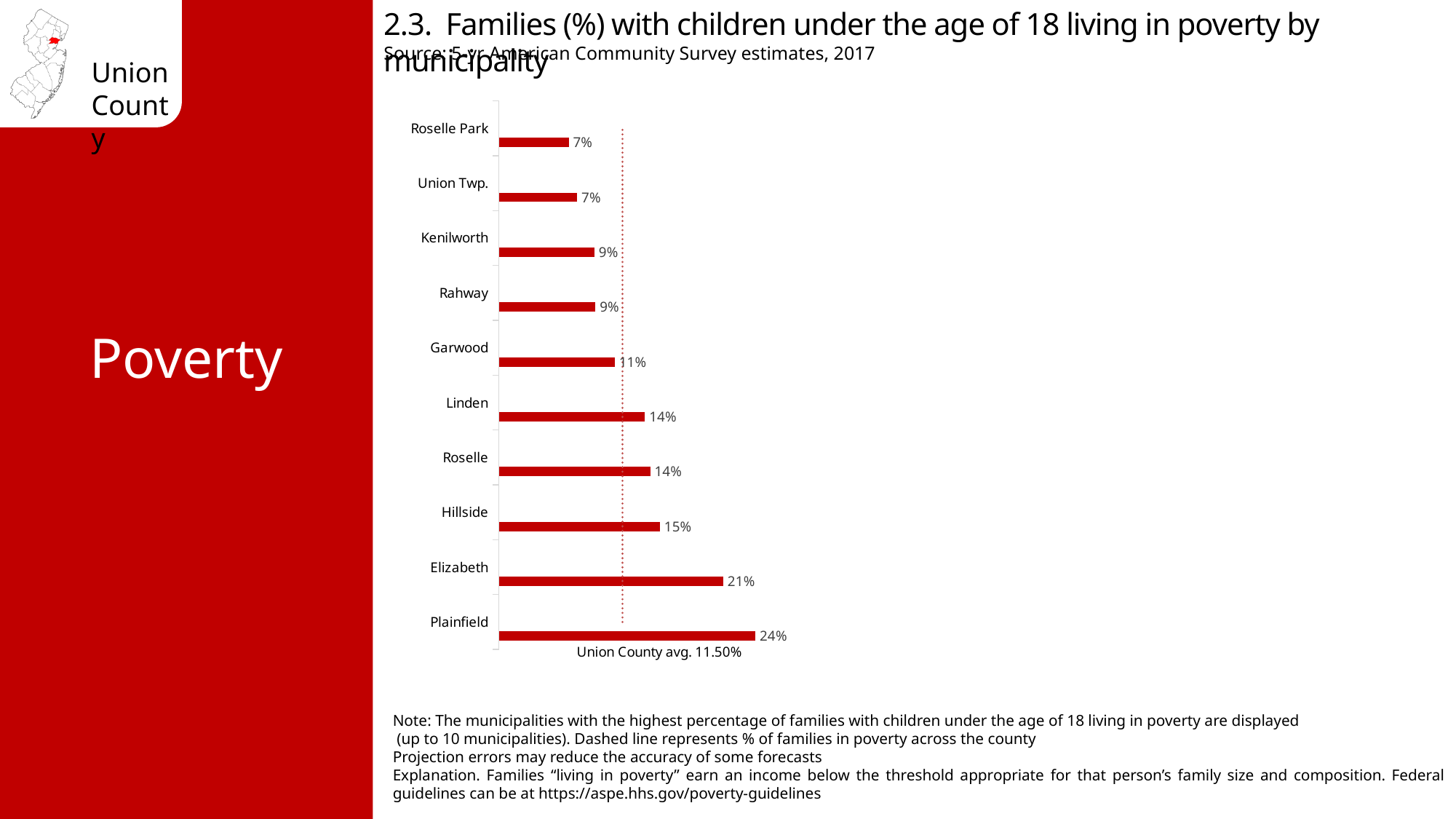
What is the value shown for Hillside? 15% Which municipality has the highest percentage of families with children under 18 living in poverty? Plainfield Which has a higher value, Linden or Kenilworth? Linden What is the value shown for Elizabeth? 21% What is the difference in percentage points between Plainfield and Elizabeth? 3 Which has a higher value, Elizabeth or Hillside? Elizabeth What kind of chart is used on this slide? Bar chart What percentage of families with children under 18 are living in poverty in Plainfield? 24% What is the difference in percentage points between Hillside and Garwood? 4 What Union County average value does the dashed line represent? 11.50% What percentage is shown for Garwood? 11% How many municipalities are shown in the chart? 10